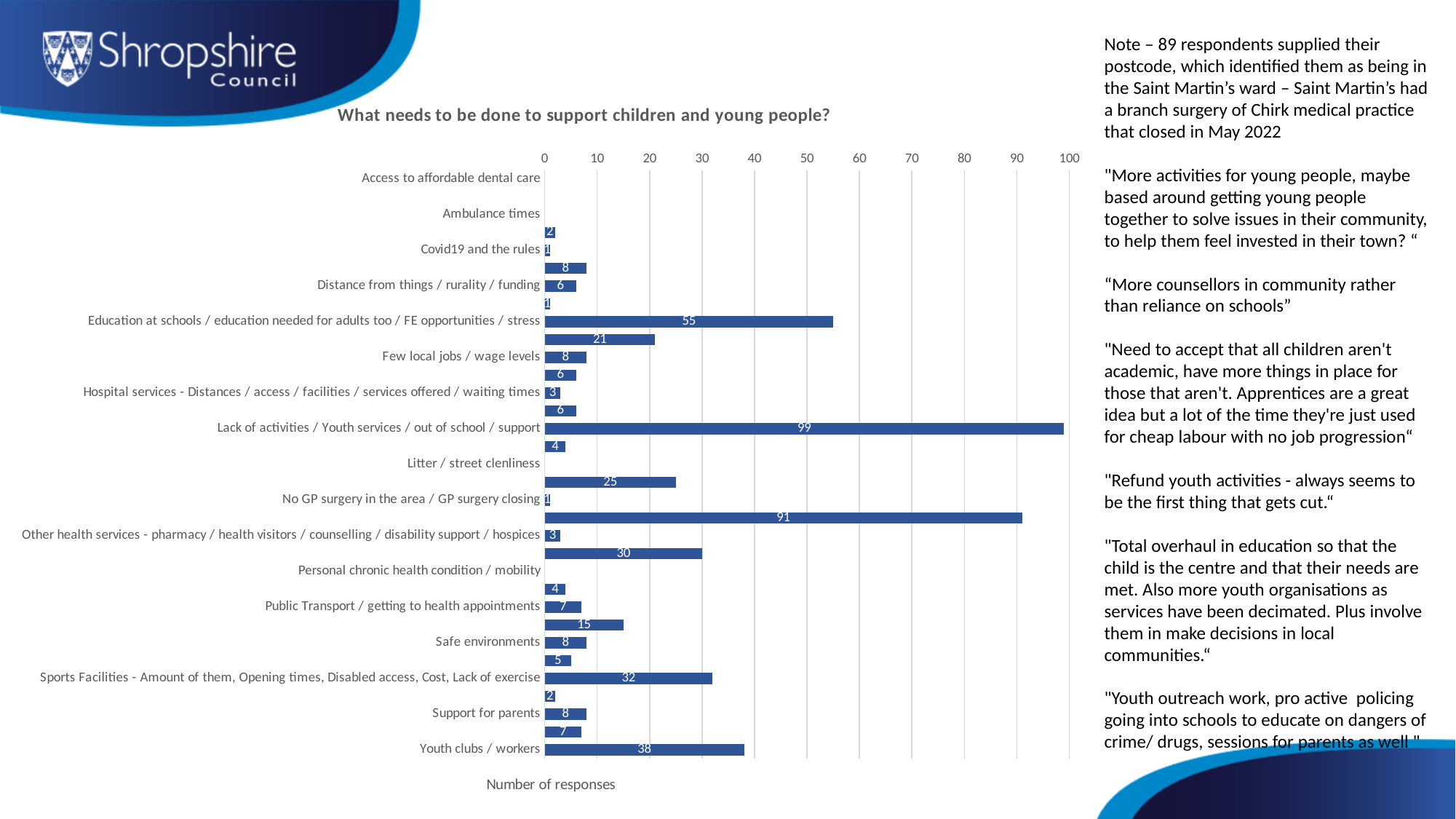
Is the value for 'Lack of activities / Youth services / out of school / support' greater or less than 90? greater How many responses are shown for 'Sports Facilities - Amount of them, Opening times, Disabled access, Cost, Lack of exercise'? 32 What is the title of the chart? What needs to be done to support children and young people? Which labelled category has the highest number of responses? Lack of activities / Youth services / out of school / support What type of chart is shown on the slide? bar chart How many responses are shown for 'Lack of activities / Youth services / out of school / support'? 99 What is the difference in responses between 'Youth clubs / workers' and 'Sports Facilities - Amount of them, Opening times, Disabled access, Cost, Lack of exercise'? 6 Which has more responses, 'Education at schools / education needed for adults too / FE opportunities / stress' or 'Youth clubs / workers'? Education at schools / education needed for adults too / FE opportunities / stress How many responses are shown for 'Education at schools / education needed for adults too / FE opportunities / stress'? 55 What is the label on the horizontal axis of the chart? Number of responses How many responses are shown for 'Public Transport / getting to health appointments'? 7 How many responses are shown for 'Youth clubs / workers'? 38